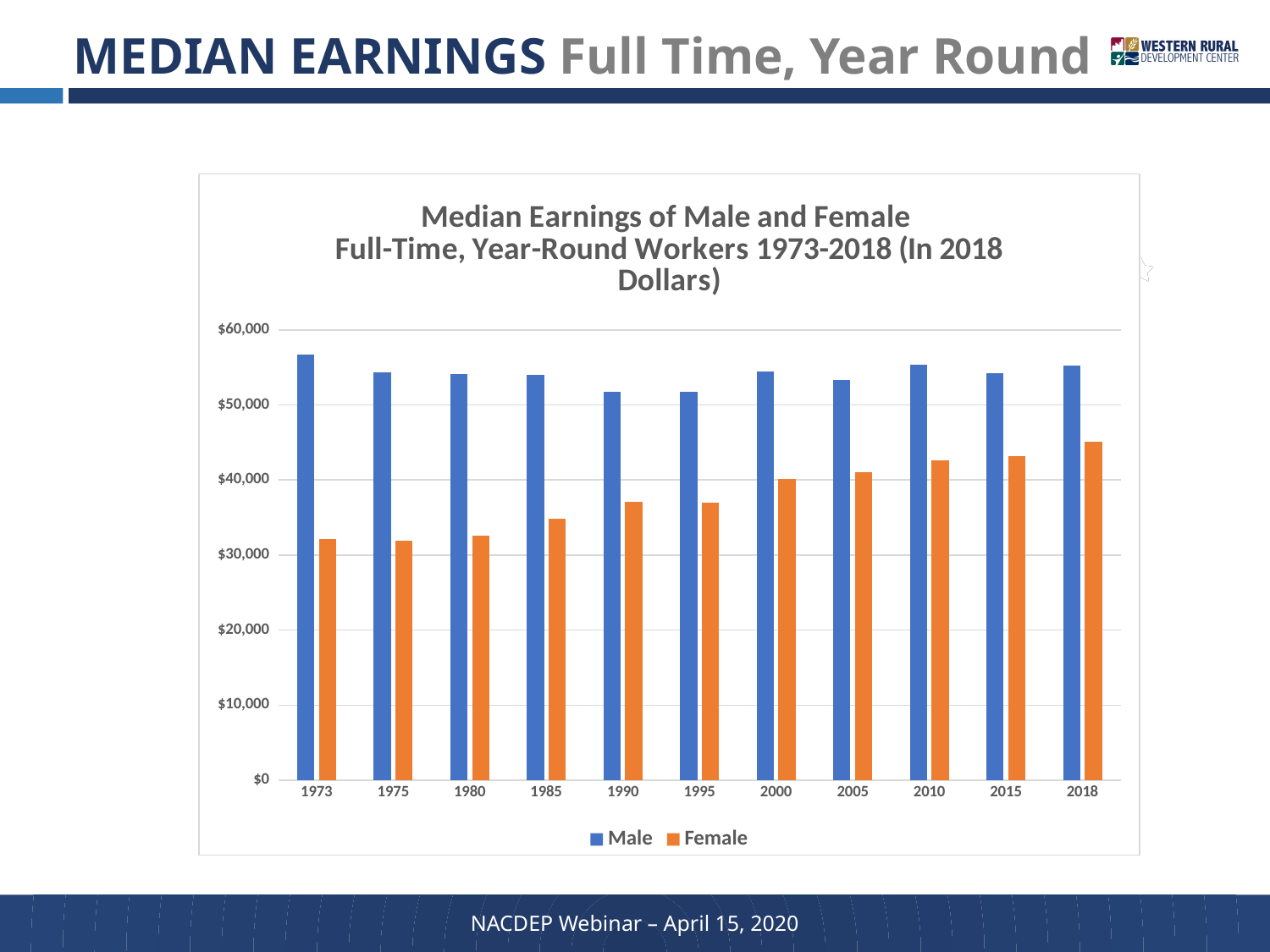
How many years are shown on the x axis? 11 Which year has the highest Female median earnings? 2018 Is the Male value for 1973 greater or less than $50,000? greater Do the Female values generally rise or fall from 1973 to 2018? rise Is the Female value for 1990 greater or less than $40,000? less Is the Female value for 2018 greater or less than $40,000? greater What kind of chart is shown on the slide? bar chart What colour are the Female bars? orange Which is larger, the Female value for 1973 or the Female value for 2018? 2018 How many series does the legend list? 2 In 2018, which is larger, the Male value or the Female value? Male